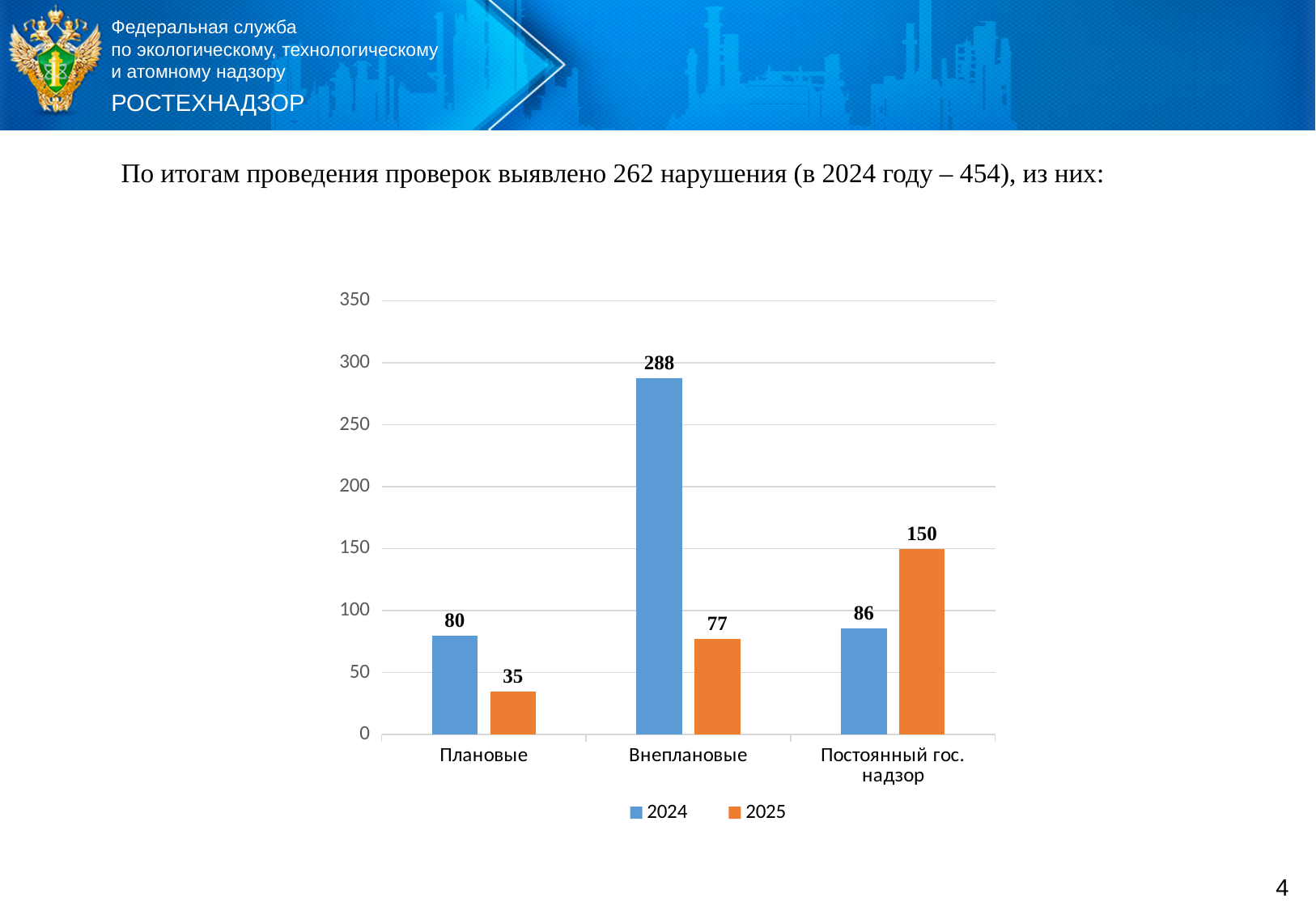
Which category has the lowest value in the 2025 series? Плановые How many categories are shown on the x axis? 3 Which category has the highest value in the 2024 series? Внеплановые What is the value for Постоянный гос. надзор in the 2025 series? 150 Which is larger for Постоянный гос. надзор: the 2024 value or the 2025 value? 2025 Is the 2024 value for Внеплановые greater or less than 250? greater Which colour represents the 2025 series in the legend? orange What is the value for Плановые in the 2024 series? 80 How many series does the legend list? 2 What is the difference between the 2024 and 2025 values for Внеплановые? 211 What kind of chart is shown on the slide? bar chart What is the value for Внеплановые in the 2025 series? 77